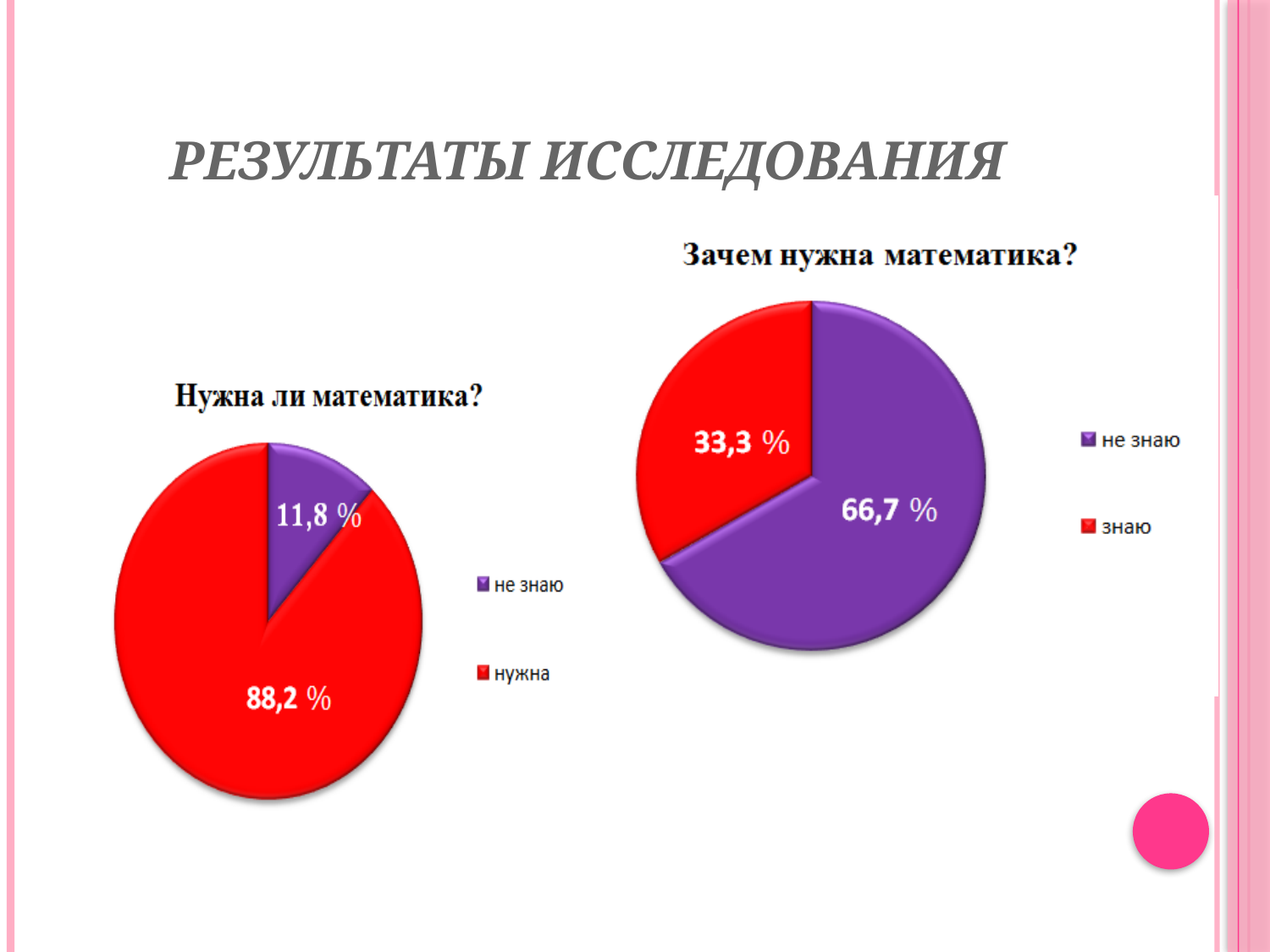
How many slices does the chart titled "Зачем нужна математика?" have? 2 In the chart titled "Нужна ли математика?", what share is labelled for "не знаю"? 11,8 % In the chart titled "Зачем нужна математика?", which is larger: "не знаю" or "знаю"? не знаю In the chart titled "Нужна ли математика?", which slice is the largest? нужна In the chart titled "Нужна ли математика?", what is the difference between the "нужна" and "не знаю" shares? 76,4 % In the chart titled "Нужна ли математика?", what colour is the "не знаю" slice? purple What kind of chart is the chart titled "Нужна ли математика?"? pie chart In the chart titled "Нужна ли математика?", what share is labelled for "нужна"? 88,2 % In the chart titled "Зачем нужна математика?", what share is labelled for "не знаю"? 66,7 % In the chart titled "Зачем нужна математика?", what is the difference between the "не знаю" and "знаю" shares? 33,4 % In the chart titled "Зачем нужна математика?", what share is labelled for "знаю"? 33,3 % In the chart titled "Зачем нужна математика?", which slice is the smallest? знаю